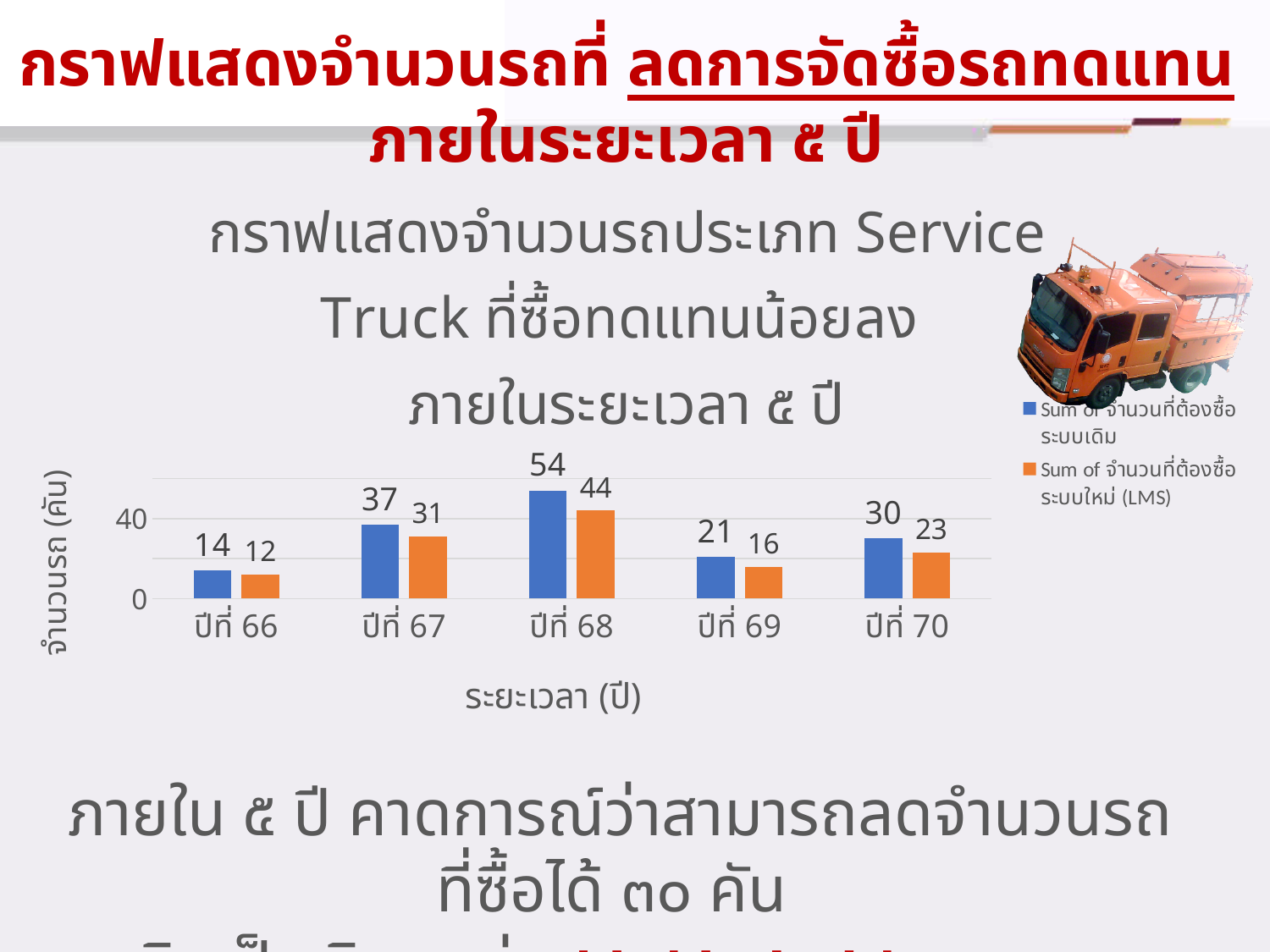
What is the label of the y axis? จำนวนรถ (คัน) What is the value of the orange series (ระบบใหม่ (LMS)) for ปีที่ 70? 23 What kind of chart is shown on the slide? Bar chart Which year has the lowest value for the orange series (ระบบใหม่ (LMS))? ปีที่ 66 What is the value of the blue series (ระบบเดิม) for ปีที่ 68? 54 How many series does the legend list? 2 How many years (categories) are shown on the x axis? 5 Which is larger for ปีที่ 70: the blue series (ระบบเดิม) or the orange series (ระบบใหม่ (LMS))? ระบบเดิม (blue) Which year has the highest value for the blue series (ระบบเดิม)? ปีที่ 68 What is the value of the orange series (ระบบใหม่ (LMS)) for ปีที่ 67? 31 What is the difference between the blue and orange values for ปีที่ 68? 10 What is the difference between the blue values for ปีที่ 67 and ปีที่ 69? 16